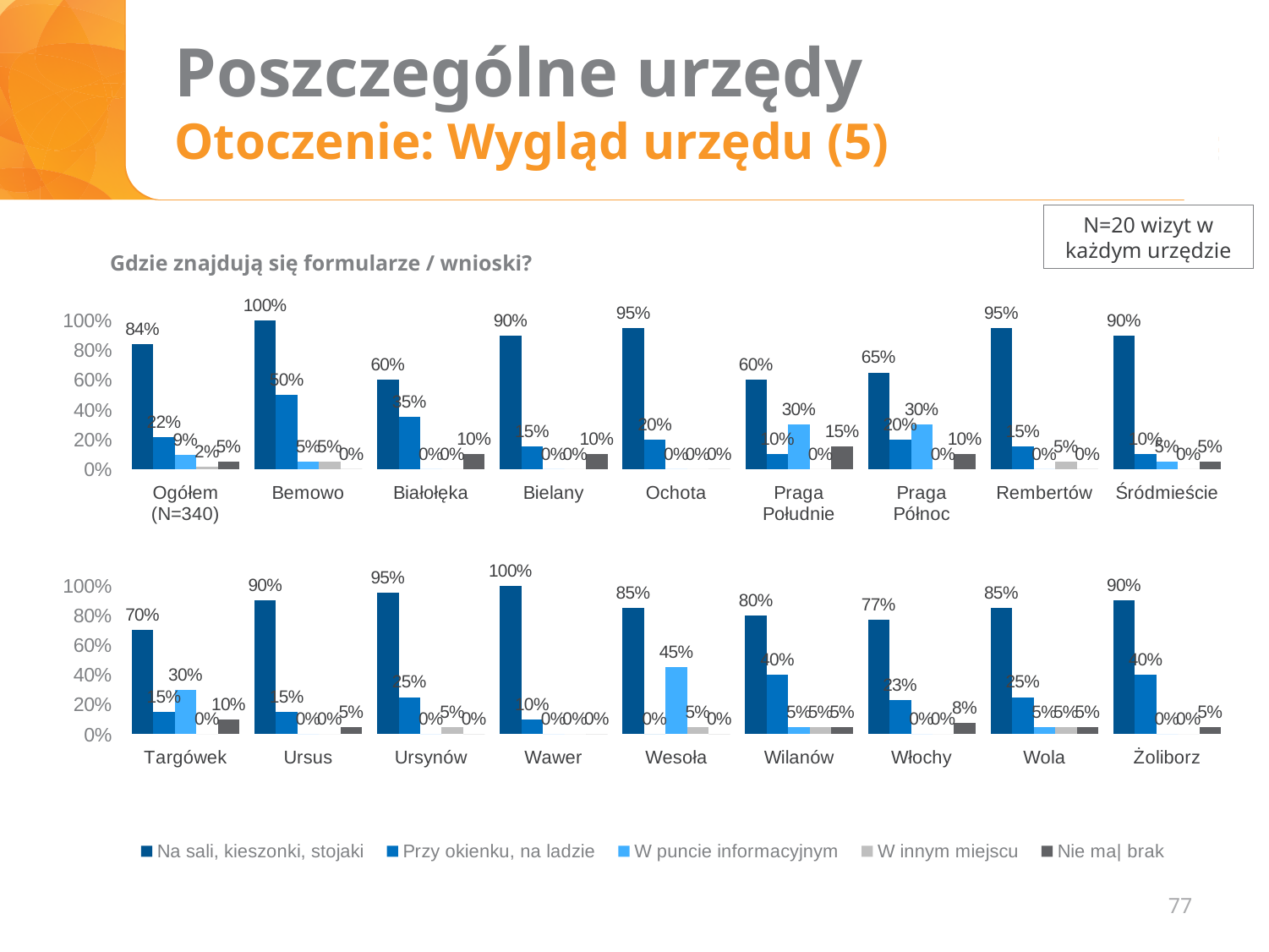
In the top chart, what is the value of 'Na sali, kieszonki, stojaki' for Bemowo? 100% In the top chart, what is the value of 'Na sali, kieszonki, stojaki' for Ogółem (N=340)? 84% In the top chart, which district has the highest value for 'Na sali, kieszonki, stojaki'? Bemowo In the bottom chart, what is the value of 'W puncie informacyjnym' for Wesoła? 45% How many series does the legend list? 5 What type of chart is used on this slide? Bar chart In the bottom chart, which is larger: the 'Na sali, kieszonki, stojaki' value for Wawer or for Wilanów? Wawer In the top chart, what is the difference between the 'Na sali, kieszonki, stojaki' values for Ochota and Białołęka? 35% In the bottom chart, which district has the lowest value for 'Na sali, kieszonki, stojaki'? Targówek What question is the chart answering, according to the subtitle above the top chart? Gdzie znajdują się formularze / wnioski? How many districts (categories) are shown in the bottom chart? 9 In the bottom chart, what is the value of 'Na sali, kieszonki, stojaki' for Włochy? 77%